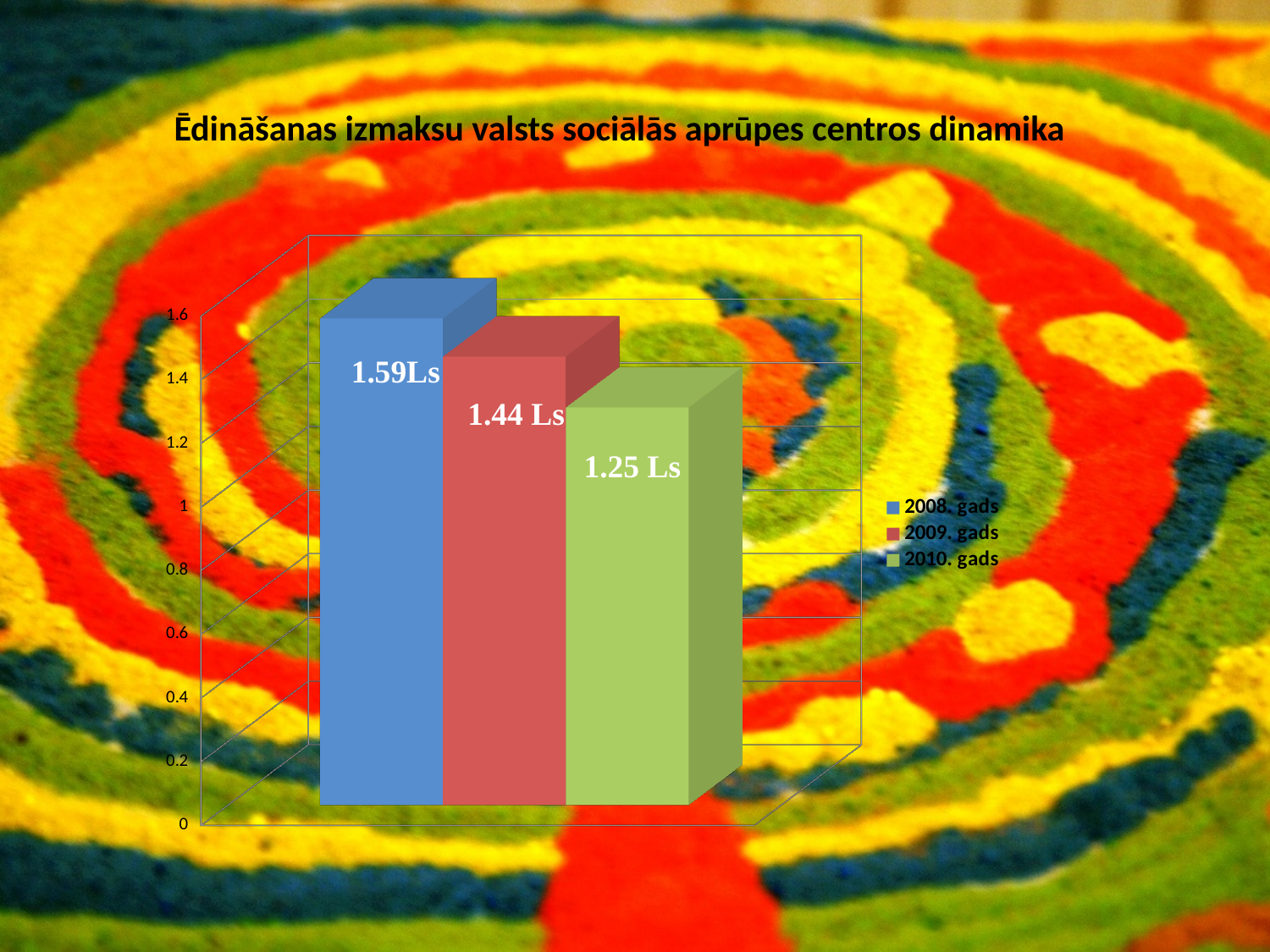
What is the value for 2010. gads? 1.25 Ls Which year has the lowest value? 2010. gads What is the value for 2009. gads? 1.44 Ls What is the difference between the values for 2009. gads and 2010. gads? 0.19 Ls Do the values rise or fall from 2008. gads to 2010. gads? fall What is the value for 2008. gads? 1.59Ls How many series does the legend list? 3 What kind of chart is shown on the slide? bar chart Is the value for 2010. gads greater or less than 1.4? less Which year has the highest value? 2008. gads Which is larger, the value for 2009. gads or the value for 2010. gads? 2009. gads What is the difference between the values for 2008. gads and 2010. gads? 0.34 Ls